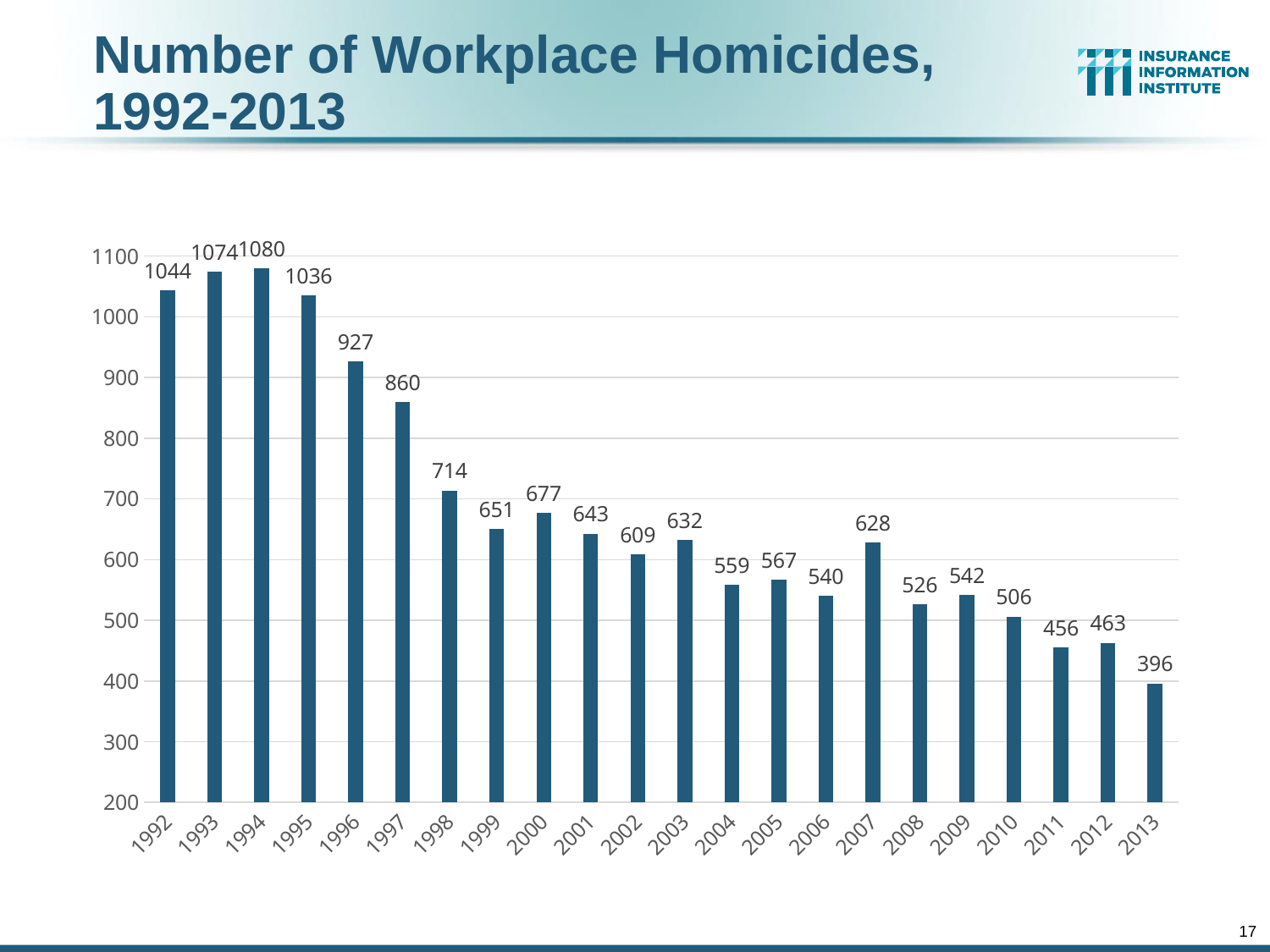
What is the number of workplace homicides in 2007? 628 How many years are shown on the x axis? 22 Which year had more workplace homicides, 2004 or 2005? 2005 What kind of chart is shown on the slide? bar chart What is the difference between the number of workplace homicides in 1992 and 2013? 648 What is the number of workplace homicides in 2013? 396 Which year has the lowest number of workplace homicides? 2013 Is the value for 1998 greater or less than 700? greater What is the number of workplace homicides in 1994? 1080 Do the values generally rise or fall from 1992 to 2013? fall What is the difference between the number of workplace homicides in 1996 and 1997? 67 Which year has the highest number of workplace homicides? 1994